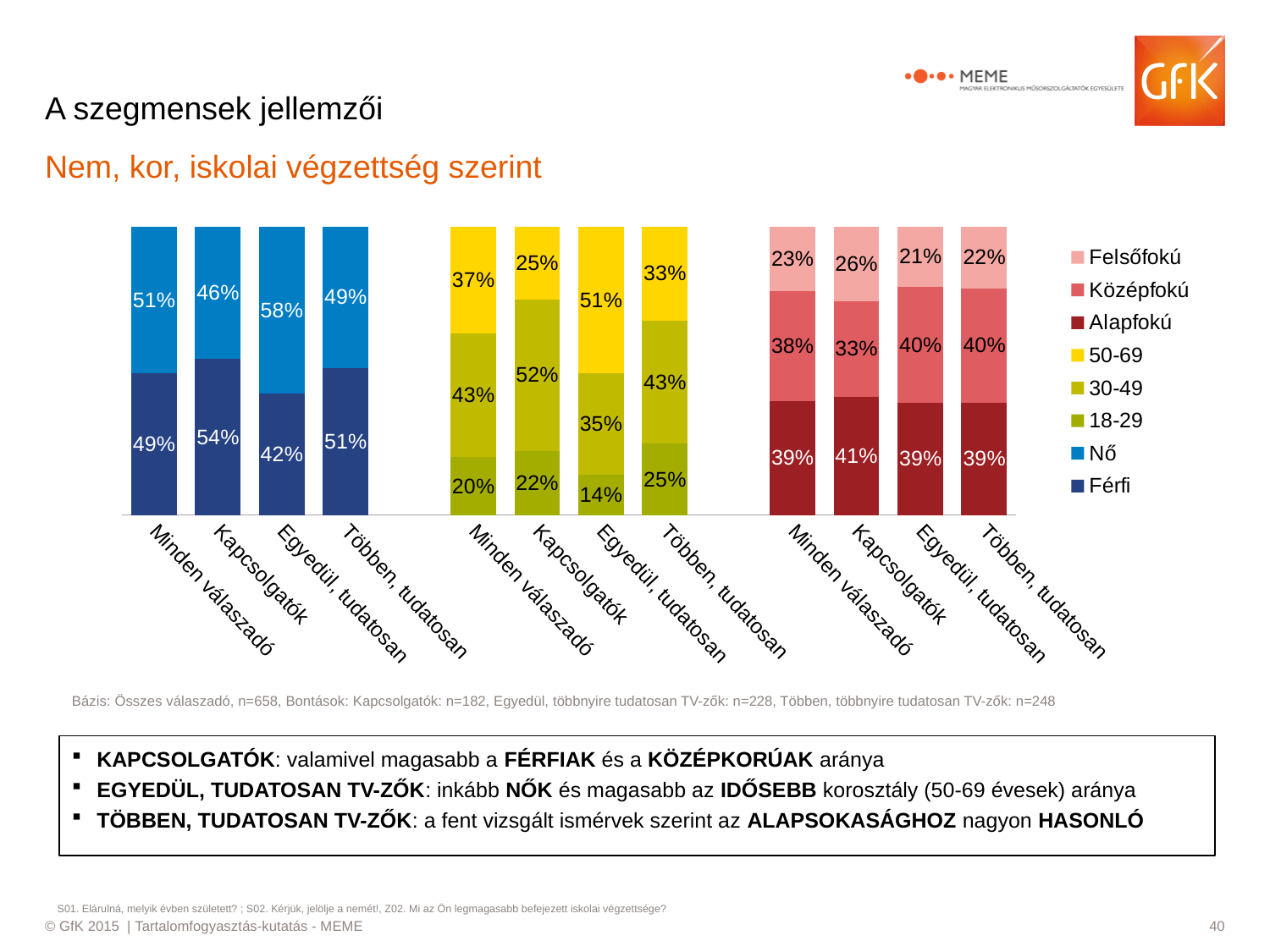
What is the share of Felsőfokú (higher education) among Kapcsolgatók? 26% What is the share of Férfi (men) among Kapcsolgatók? 54% What is the difference between the share of Nő and Férfi in the Egyedül, tudatosan group? 16% What is the share of the 18-29 age group among Minden válaszadó? 20% What is the share of the 50-69 age group among Egyedül, tudatosan respondents? 51% What is the share of Középfokú (secondary education) among Többen, tudatosan respondents? 40% How many series does the legend list? 8 Which group has the lowest share of 18-29 year olds? Egyedül, tudatosan Is the share of Férfi larger among Kapcsolgatók or among Egyedül, tudatosan respondents? Kapcsolgatók What kind of chart is shown on the slide? Stacked bar chart Which group has the highest share of the 30-49 age group? Kapcsolgatók What is the share of Nő (women) in the Egyedül, tudatosan group? 58%